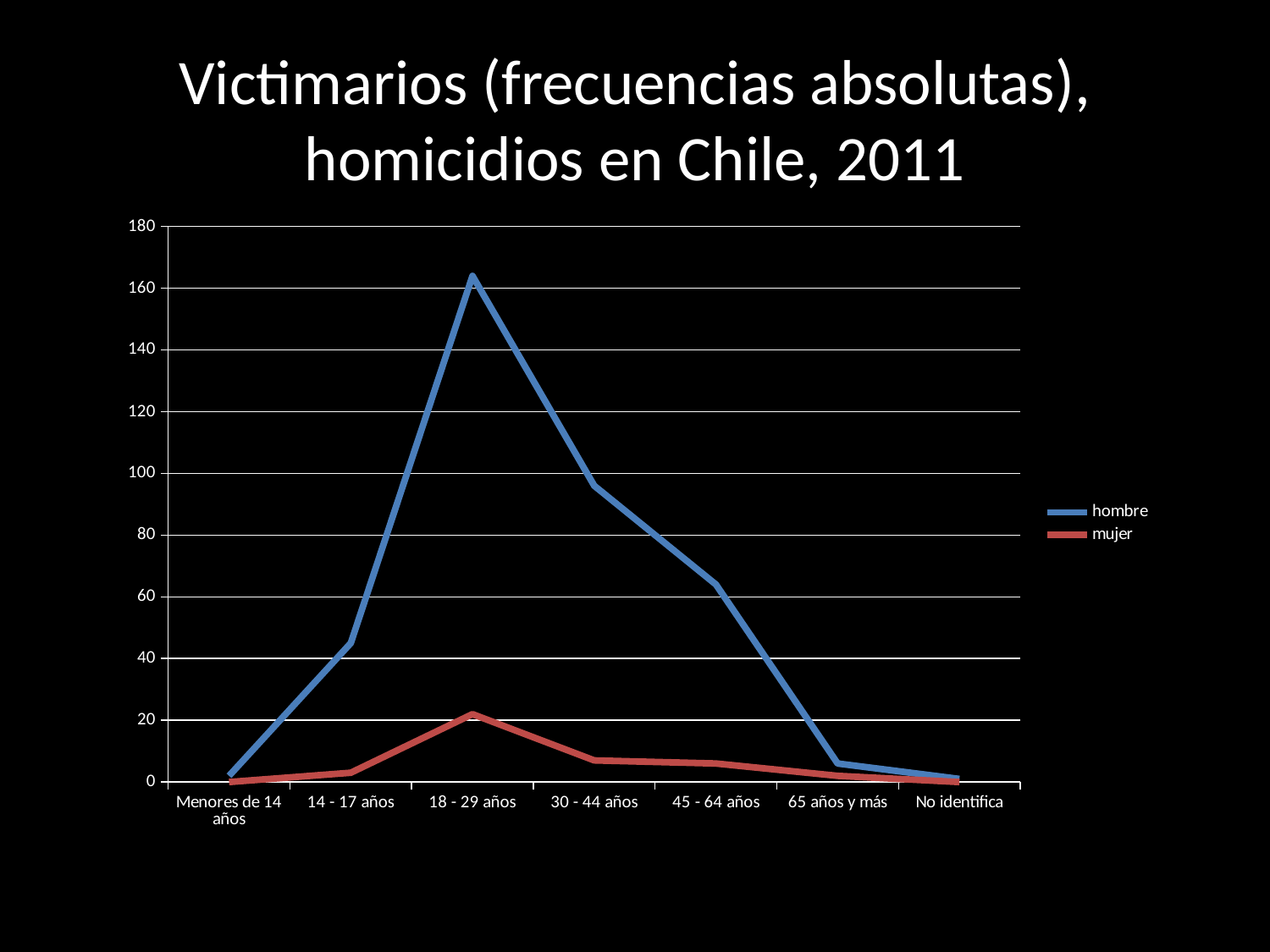
Do the hombre values rise or fall from 18 - 29 años to No identifica? fall What colour is the line for the mujer series? red For which age category is the mujer series highest? 18 - 29 años Is the value for hombre at 18 - 29 años greater or less than 140? greater How many age categories are shown on the x axis? 7 Is the value for hombre at 45 - 64 años greater or less than 80? less For which age category is the hombre series highest? 18 - 29 años Which series has the larger value at 18 - 29 años, hombre or mujer? hombre Is the value for hombre at 30 - 44 años greater or less than 80? greater What kind of chart is shown on the slide? line chart How many series does the legend list? 2